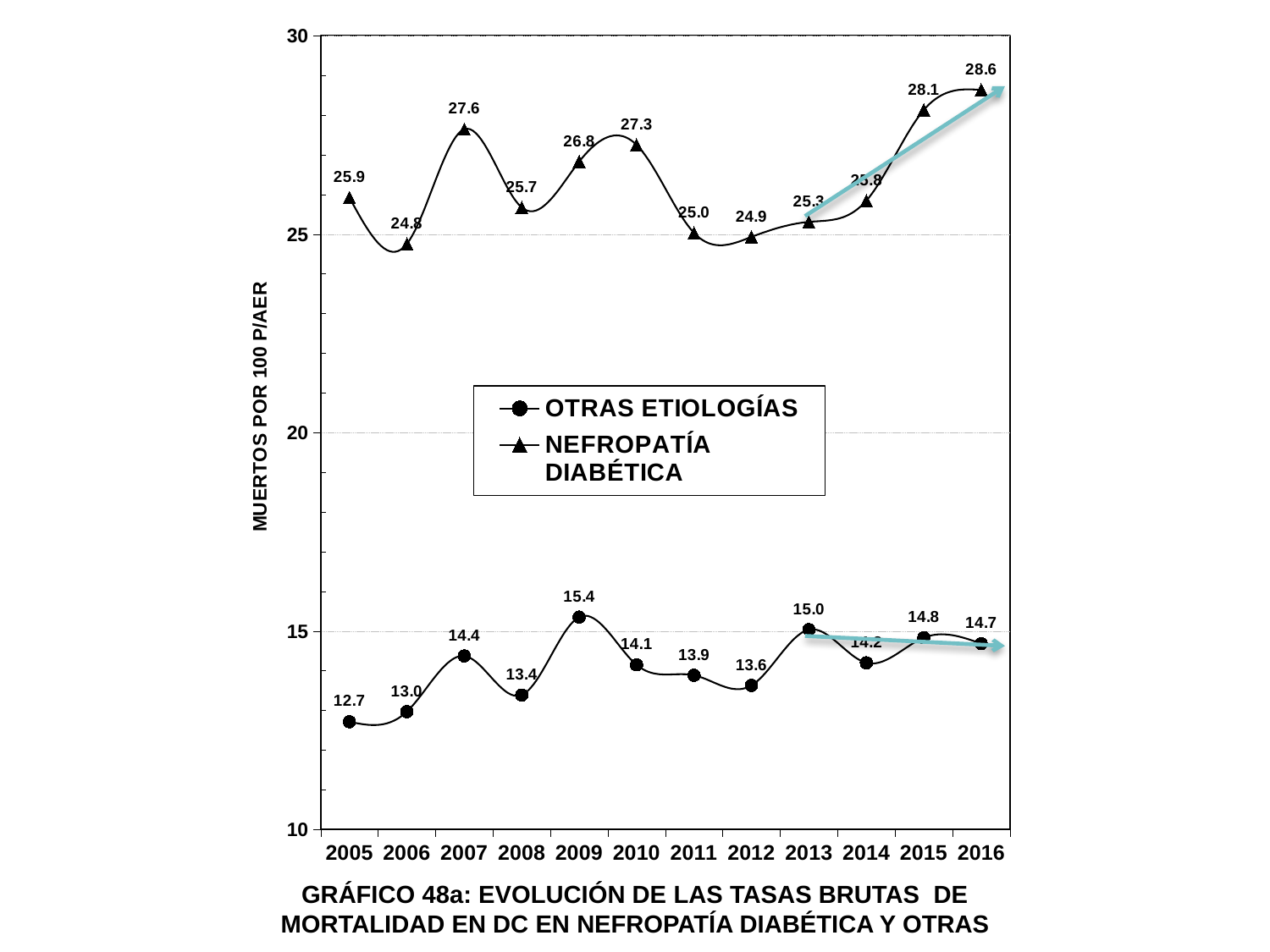
How many series does the legend list? 2 What is the label of the y axis? MUERTOS POR 100 P/AER Which is larger: the OTRAS ETIOLOGÍAS value in 2007 or in 2008? 2007 What is the value for NEFROPATÍA DIABÉTICA in 2016? 28.6 How many years are shown on the x axis? 12 In which year is the OTRAS ETIOLOGÍAS series at its lowest? 2005 What is the difference between the NEFROPATÍA DIABÉTICA value in 2016 and in 2015? 0.5 What is the value for NEFROPATÍA DIABÉTICA in 2006? 24.8 In which year is the NEFROPATÍA DIABÉTICA series at its highest? 2016 What kind of chart is shown on the slide? Line chart What is the value for OTRAS ETIOLOGÍAS in 2009? 15.4 What is the difference between the OTRAS ETIOLOGÍAS value in 2013 and in 2012? 1.4